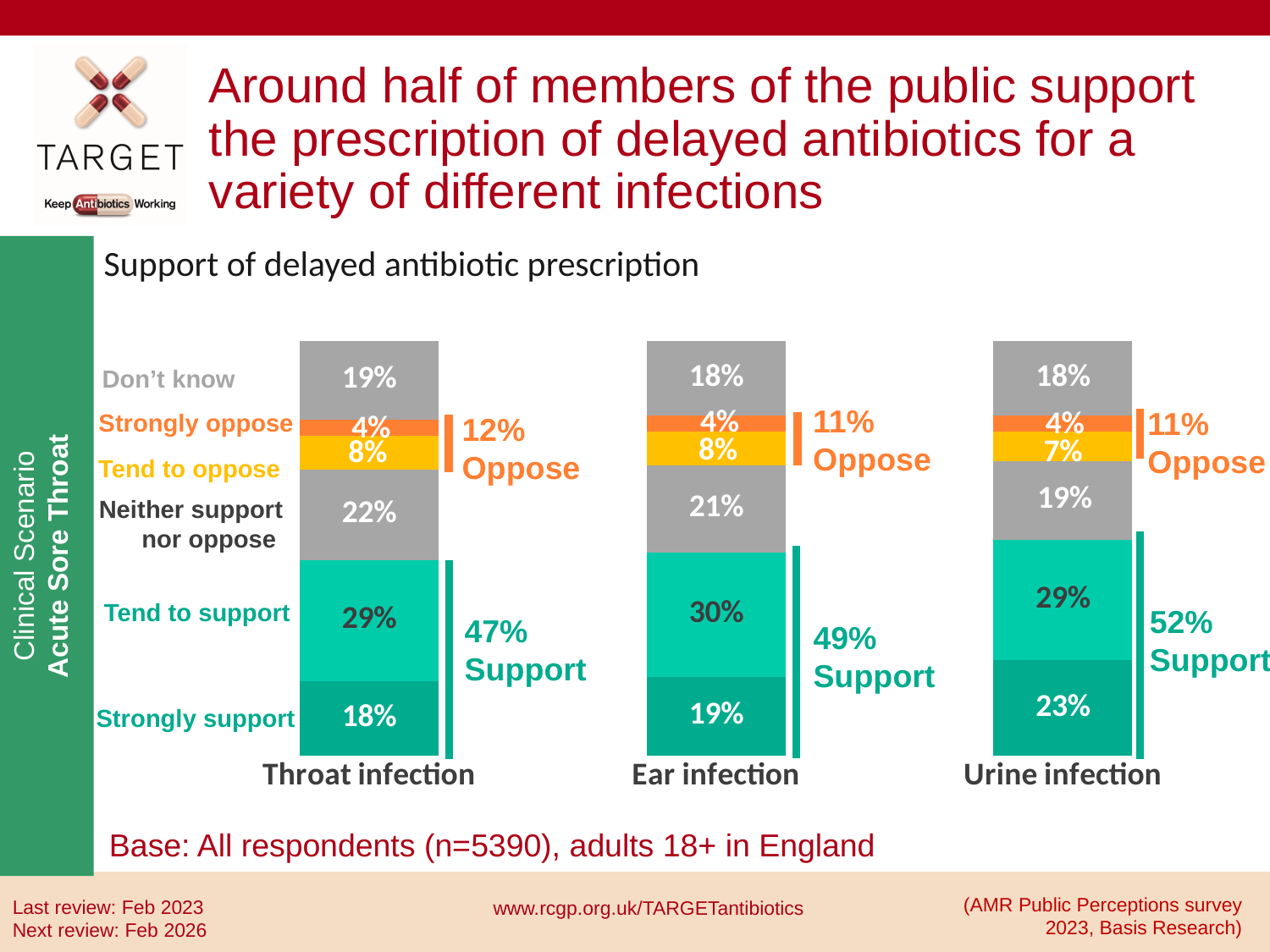
How many response categories are listed down the left side of the chart? 6 Which infection has the highest combined 'Oppose' percentage? Throat infection What percentage of respondents 'Tend to support' delayed antibiotic prescription for a throat infection? 29% Is the 'Tend to support' percentage larger for ear infection or throat infection? Ear infection How many infection types are shown on the x axis of the chart? 3 What is the combined 'Support' percentage shown for ear infection? 49% Which infection has the highest combined 'Support' percentage? Urine infection What type of chart is shown on the slide? Stacked bar chart What is the title of the chart? Support of delayed antibiotic prescription What is the difference between the 'Strongly support' percentages for urine infection and throat infection? 5% What percentage of respondents 'Strongly support' delayed antibiotic prescription for a urine infection? 23% What is the 'Don't know' percentage for ear infection? 18%